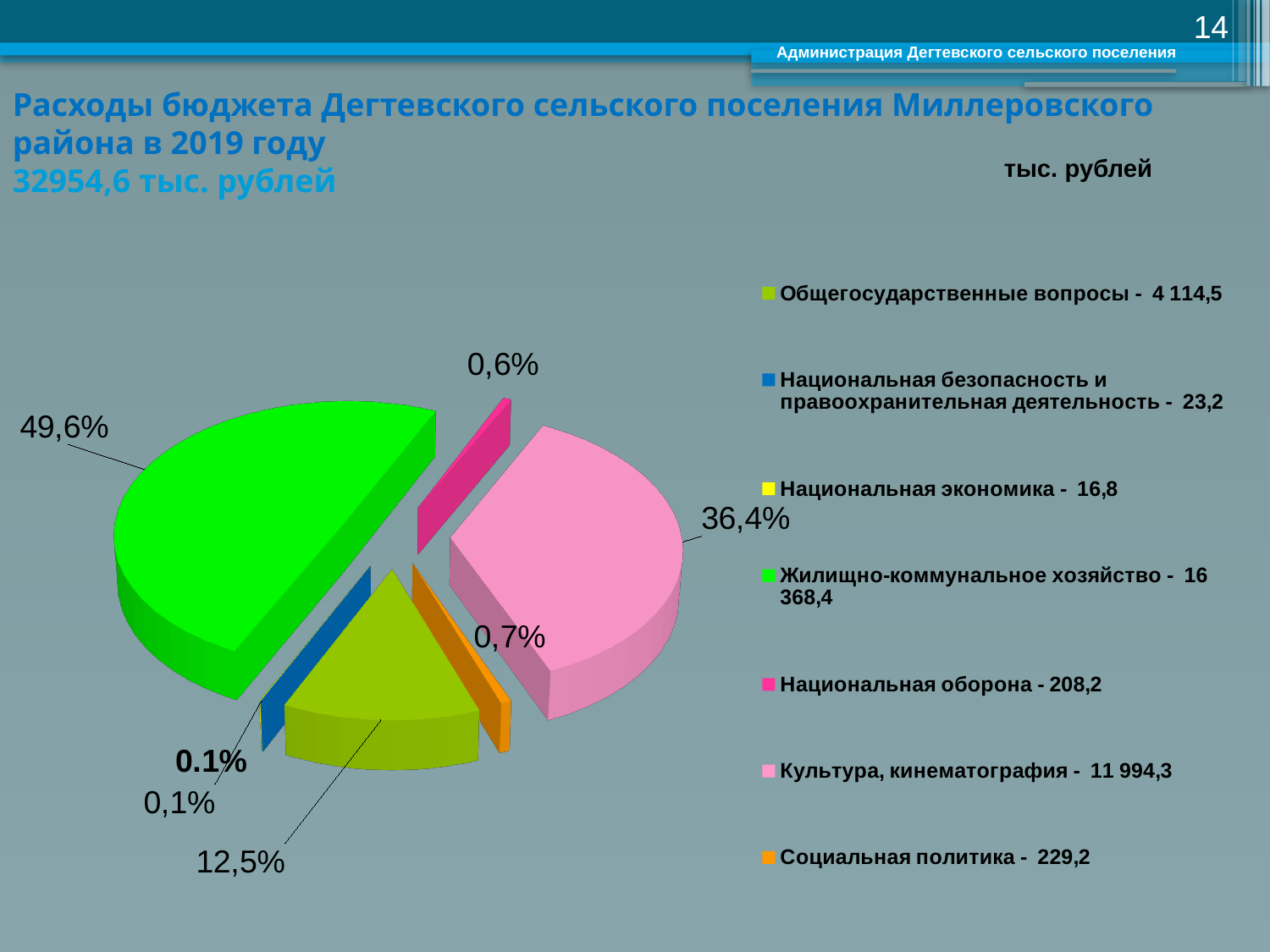
Which category has the smallest value in the legend? Национальная экономика Which category has the largest share of the pie? Жилищно-коммунальное хозяйство What is the value for Национальная оборона according to the legend? 208,2 How many categories does the legend of the pie chart list? 7 What is the value for Культура, кинематография according to the legend? 11 994,3 What is the value for Общегосударственные вопросы according to the legend? 4 114,5 What share of the pie does Культура, кинематография take? 36,4% What is the value for Жилищно-коммунальное хозяйство according to the legend? 16 368,4 What is the value for Социальная политика according to the legend? 229,2 What kind of chart is shown on the slide? pie chart What total budget expenditure amount is stated in the slide title? 32954,6 тыс. рублей Which is larger: the value for Социальная политика or the value for Национальная оборона? Социальная политика